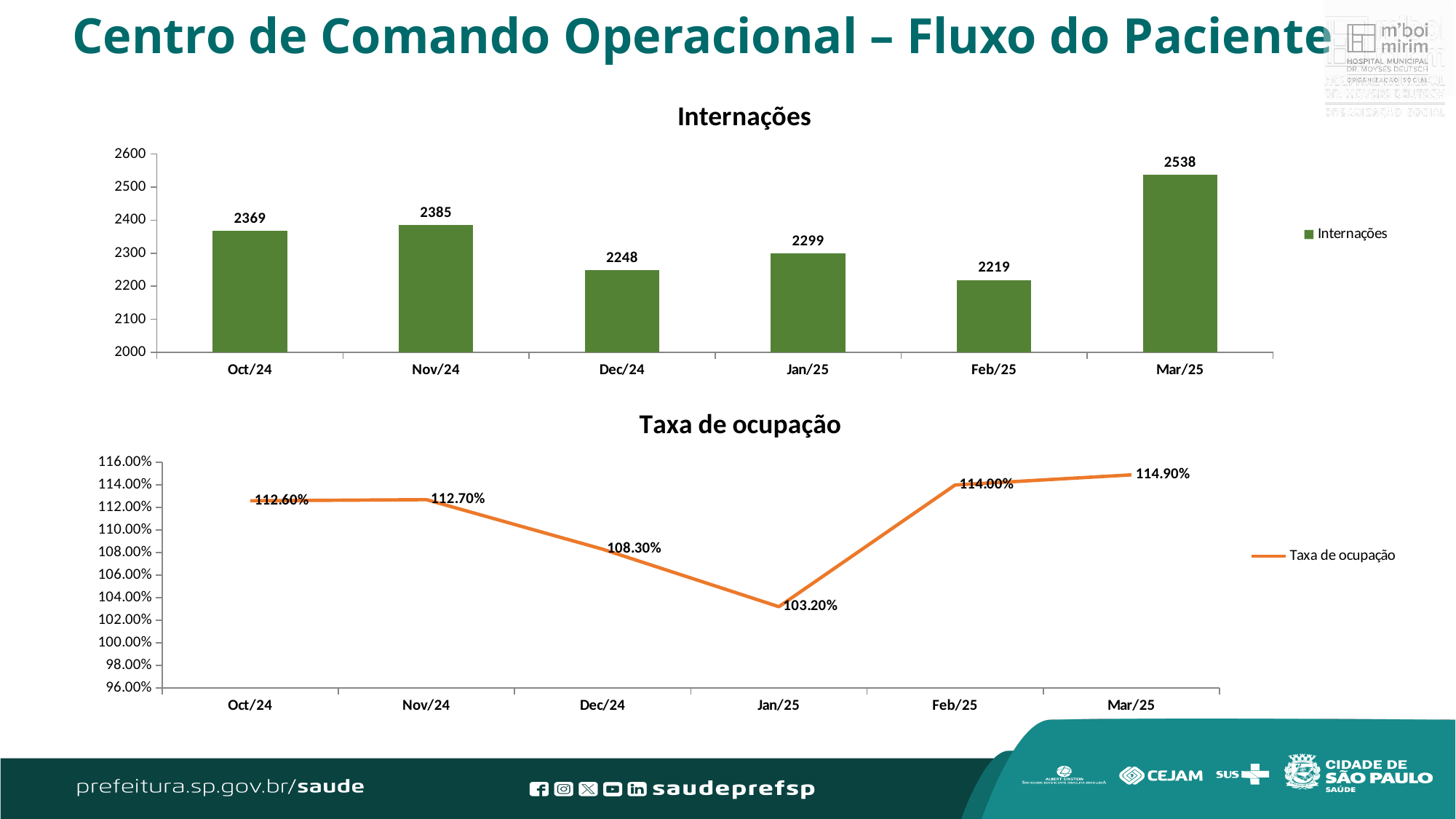
In the Taxa de ocupação chart, which month has the highest value? Mar/25 In the Taxa de ocupação chart, do the values rise or fall from Jan/25 to Mar/25? rise In the Internações chart, what is the difference between the values for Mar/25 and Feb/25? 319 In the Internações chart, which is larger, the value for Oct/24 or the value for Nov/24? Nov/24 In the Internações chart, how many months are shown on the x axis? 6 In the Internações chart, which month has the lowest value? Feb/25 What kind of chart is the Taxa de ocupação chart? line chart In the Internações chart, what is the value for Mar/25? 2538 What kind of chart is the Internações chart? bar chart In the Internações chart, what is the value for Dec/24? 2248 In the Internações chart, which month has the highest value? Mar/25 In the Taxa de ocupação chart, what is the value for Jan/25? 103.20%